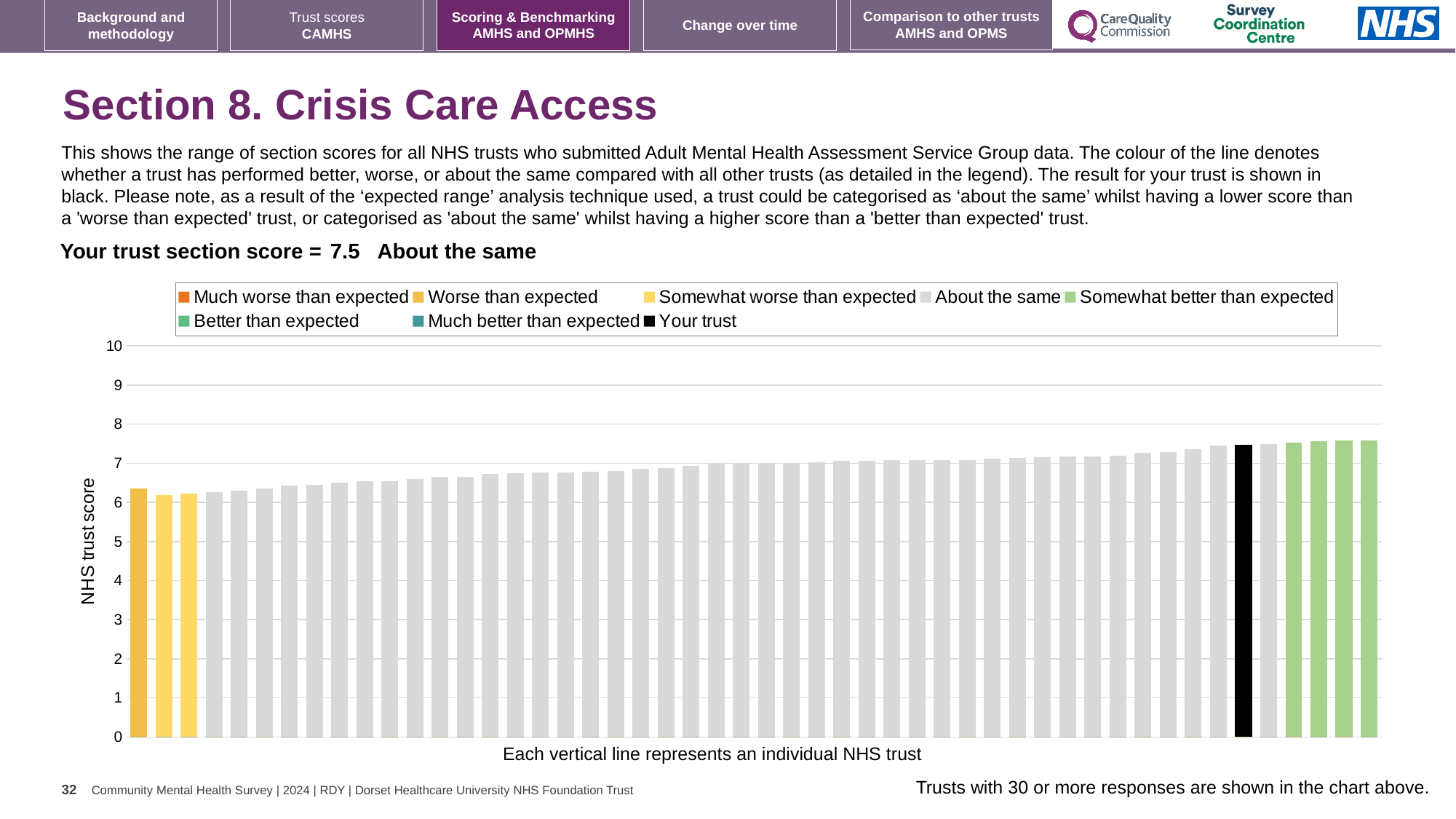
Is the value of the black bar (your trust) greater or less than 7? greater How many entries does the chart legend list? 8 How is your trust's score categorised compared with other trusts? About the same What is the label on the vertical axis of the chart? NHS trust score Which is larger, the leftmost bar or the rightmost bar? the rightmost bar Do the bar values rise or fall from left to right across the chart? rise Is the value of the leftmost bar greater or less than 7? less What colour is the bar representing your trust? black What kind of chart is shown on the slide? bar chart Is the value of the rightmost bar greater or less than 8? less What is the section score for your trust, as stated on the slide? 7.5 How many bars are coloured green (somewhat better than expected)? 4